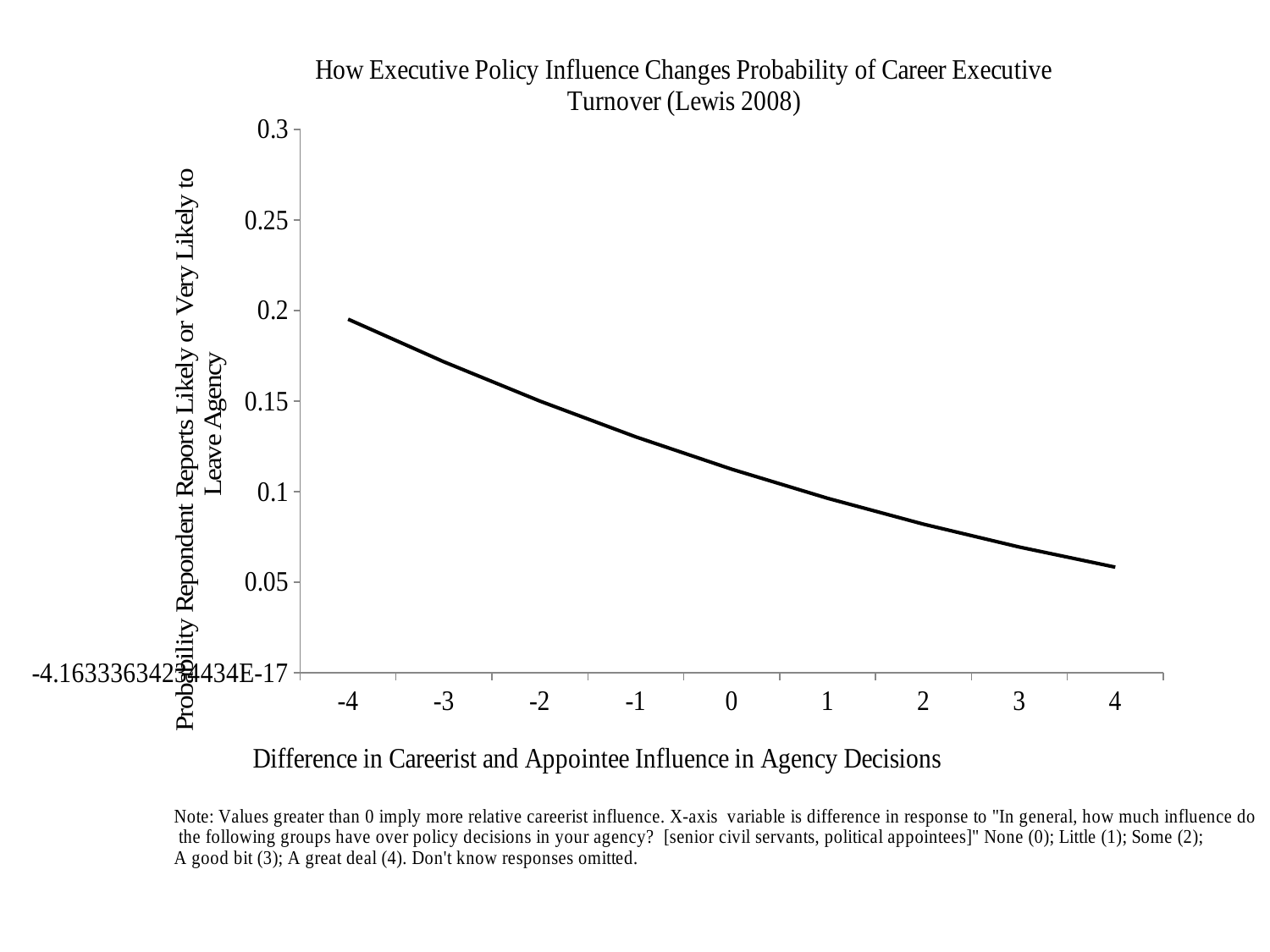
What is the x-axis label of the chart? Difference in Careerist and Appointee Influence in Agency Decisions What kind of chart is shown on the slide? line chart Is the probability at a difference of -4 greater or less than 0.15? greater Is the probability at a difference of 0 greater or less than 0.15? less Does the probability of leaving the agency rise or fall as the difference in careerist and appointee influence increases from -4 to 4? fall Is the probability at a difference of -3 greater or less than 0.15? greater At which x-axis value is the probability of leaving the agency lowest? 4 How many labelled tick values are shown on the x axis? 9 Which has the higher probability of leaving the agency: a difference of -4 or a difference of 4? -4 At which x-axis value is the probability of leaving the agency highest? -4